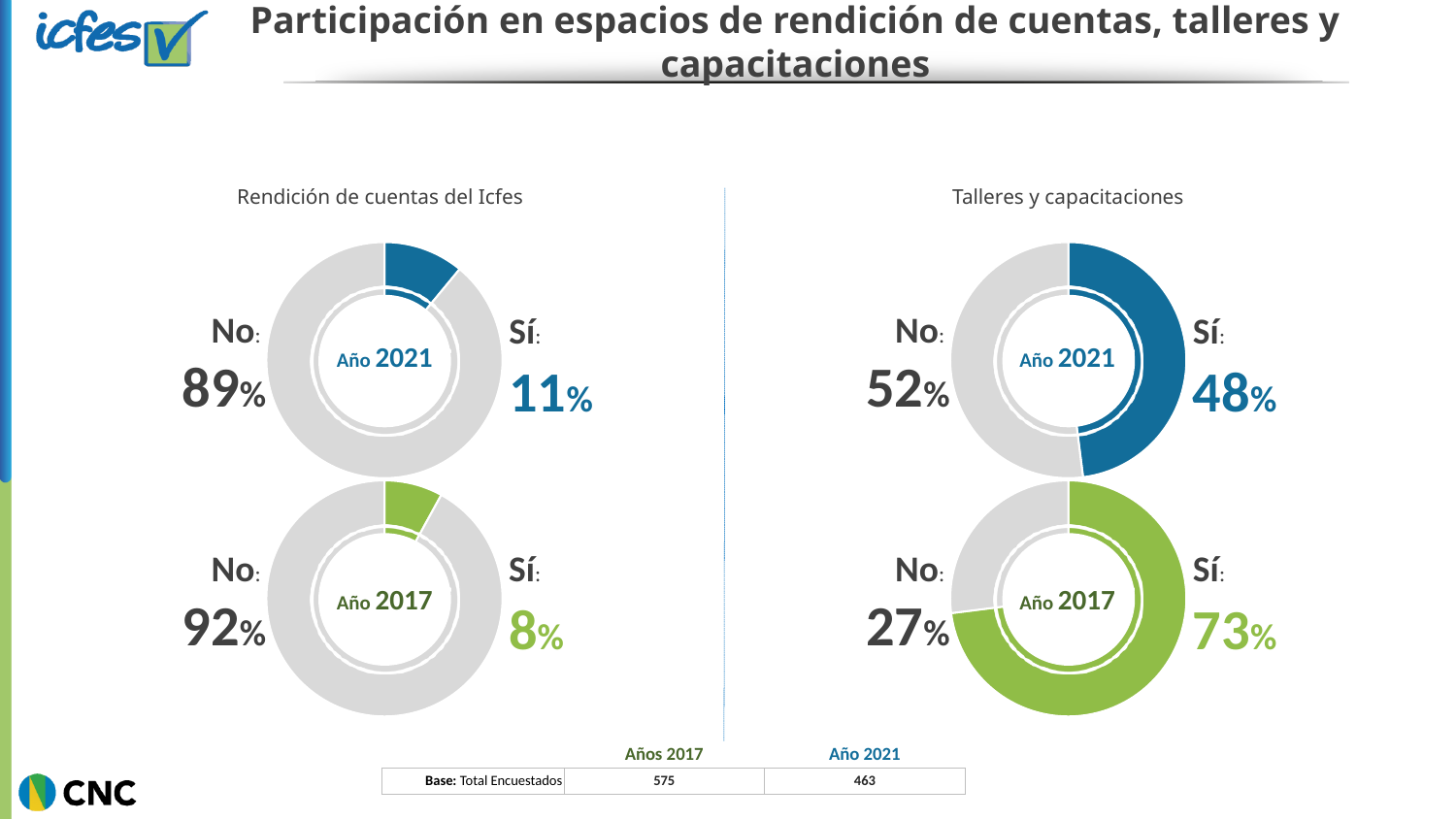
In the 'Talleres y capacitaciones' Año 2017 chart, what percentage answered No? 27% In the 'Talleres y capacitaciones' Año 2021 chart, what percentage answered Sí? 48% In the 'Rendición de cuentas del Icfes' Año 2021 chart, what percentage answered Sí? 11% How many donut charts are shown on the slide? 4 What type of chart is used to show the Sí/No results on this slide? Donut (pie) chart Did the Sí share for 'Talleres y capacitaciones' rise or fall from Año 2017 to Año 2021? Fall In the 'Rendición de cuentas del Icfes' Año 2017 chart, what percentage answered No? 92% What is the difference between the Sí percentage for 'Rendición de cuentas del Icfes' in Año 2021 and in Año 2017? 3 percentage points In the 'Talleres y capacitaciones' Año 2017 chart, which response has the larger share, Sí or No? Sí According to the base table, how many respondents were surveyed in Año 2021? 463 What is the difference between the Sí percentage for 'Talleres y capacitaciones' in Año 2017 and in Año 2021? 25 percentage points In the 'Rendición de cuentas del Icfes' Año 2021 chart, which response has the smaller share? Sí